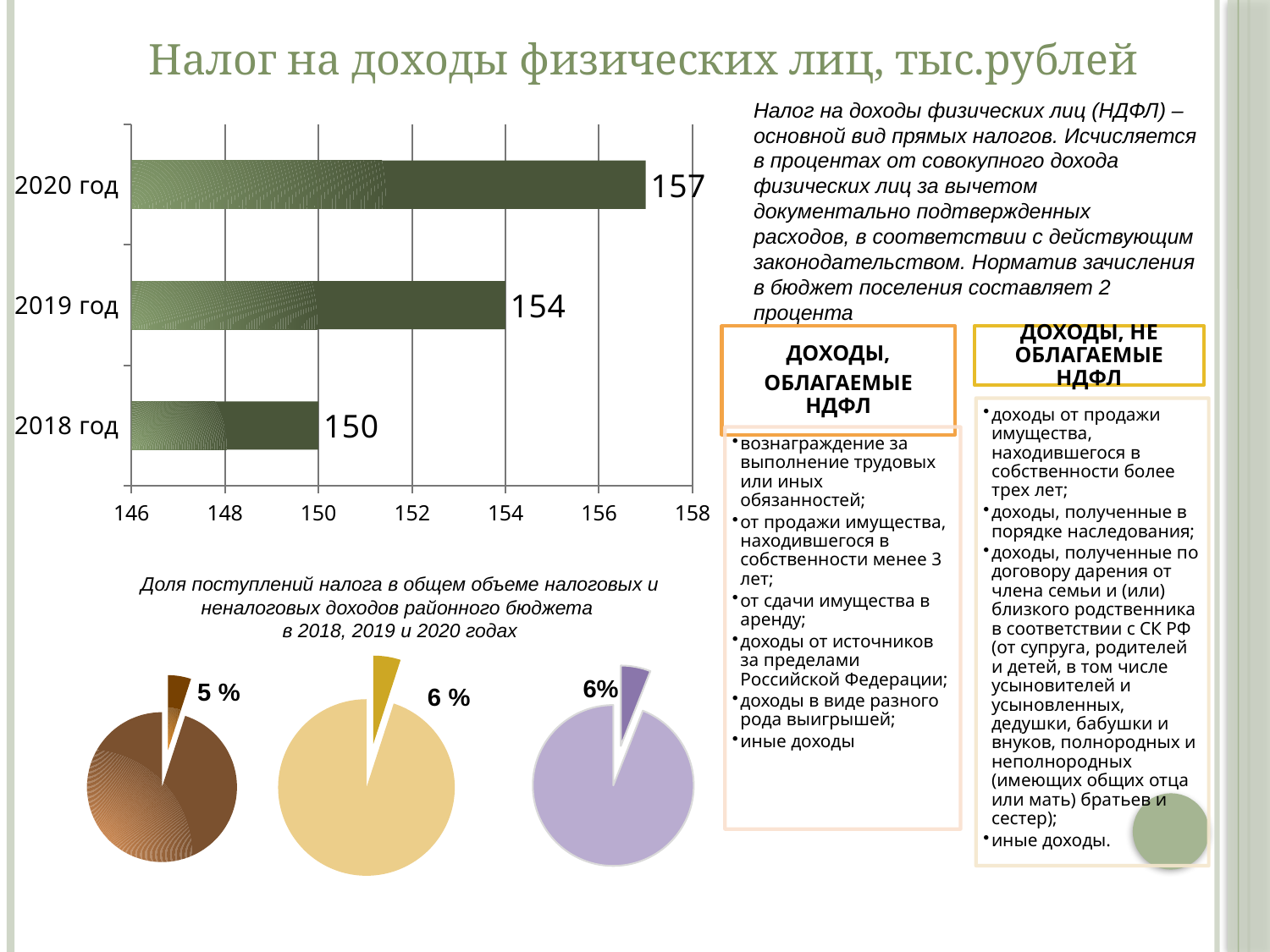
On the bar chart, which year has the highest value? 2020 год On the bar chart, do the values rise or fall from 2018 год to 2020 год? rise What type of chart is the chart at the top left of the slide? bar chart On the bar chart, what is the difference between the values for 2019 год and 2018 год? 4 On the bar chart, what is the value for 2019 год? 154 On the bar chart, which is larger: the value for 2019 год or the value for 2020 год? 2020 год On the bar chart, what is the value for 2020 год? 157 On the leftmost (brown) pie chart at the bottom of the slide, what share is shown for the separated slice? 5 % On the bar chart, what is the difference between the values for 2020 год and 2018 год? 7 How many bars are shown on the bar chart? 3 On the bar chart, which year has the lowest value? 2018 год On the bar chart, what is the value for 2018 год? 150